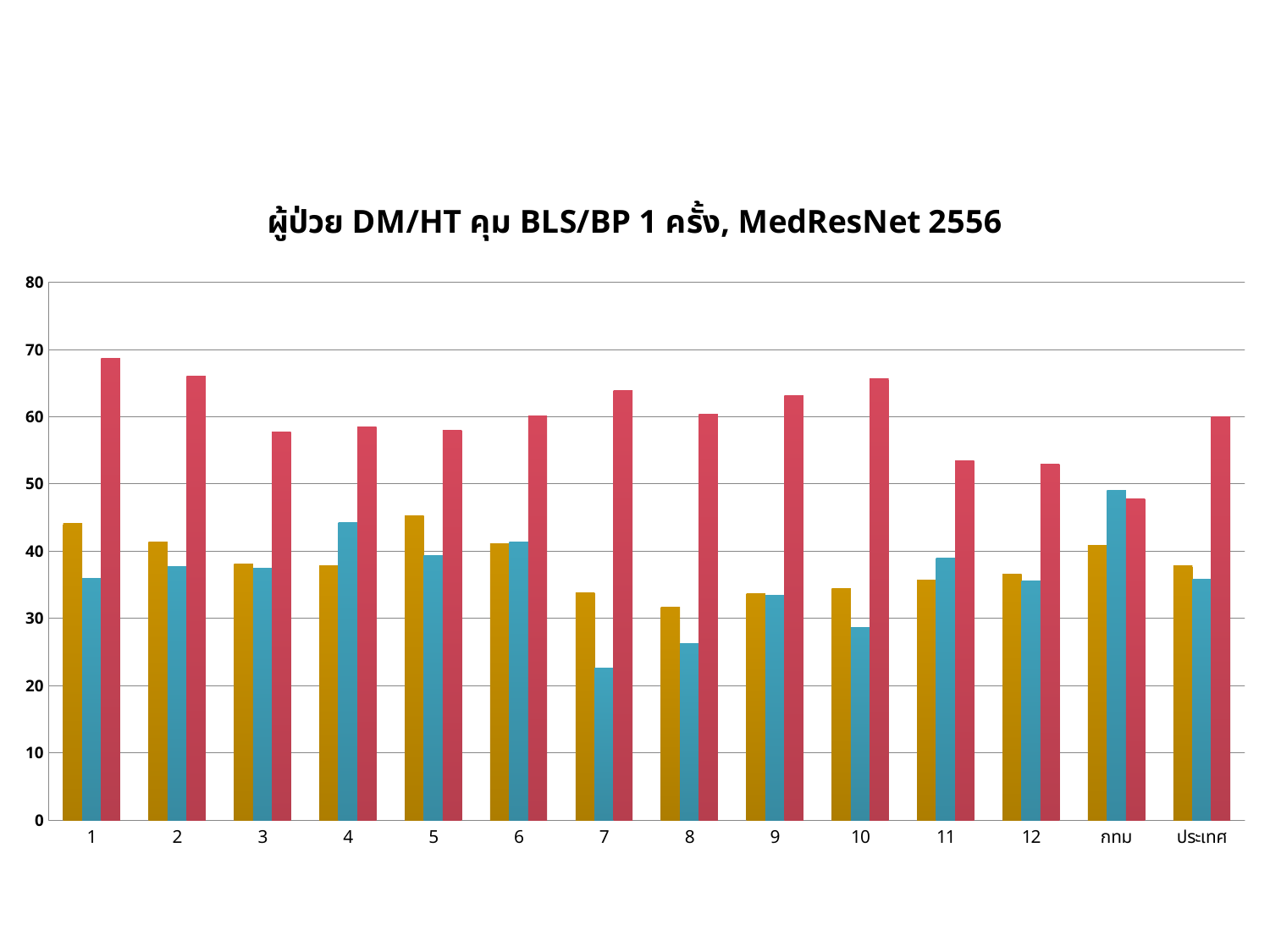
Which category has the shortest blue bar? 7 How many bars are plotted for each category? 3 How many categories are shown along the x axis? 14 Which category has the tallest red bar? 1 What kind of chart is shown on the slide? bar chart Which category has the tallest blue bar? กทม What is the title of the chart? ผู้ป่วย DM/HT คุม BLS/BP 1 ครั้ง, MedResNet 2556 Is the blue bar for category 7 greater or less than 30? less For category 4, which is taller, the blue bar or the gold bar? the blue bar Is the red bar for category 1 greater or less than 60? greater Which category has the shortest red bar? กทม For category กทม, which is taller, the blue bar or the gold bar? the blue bar